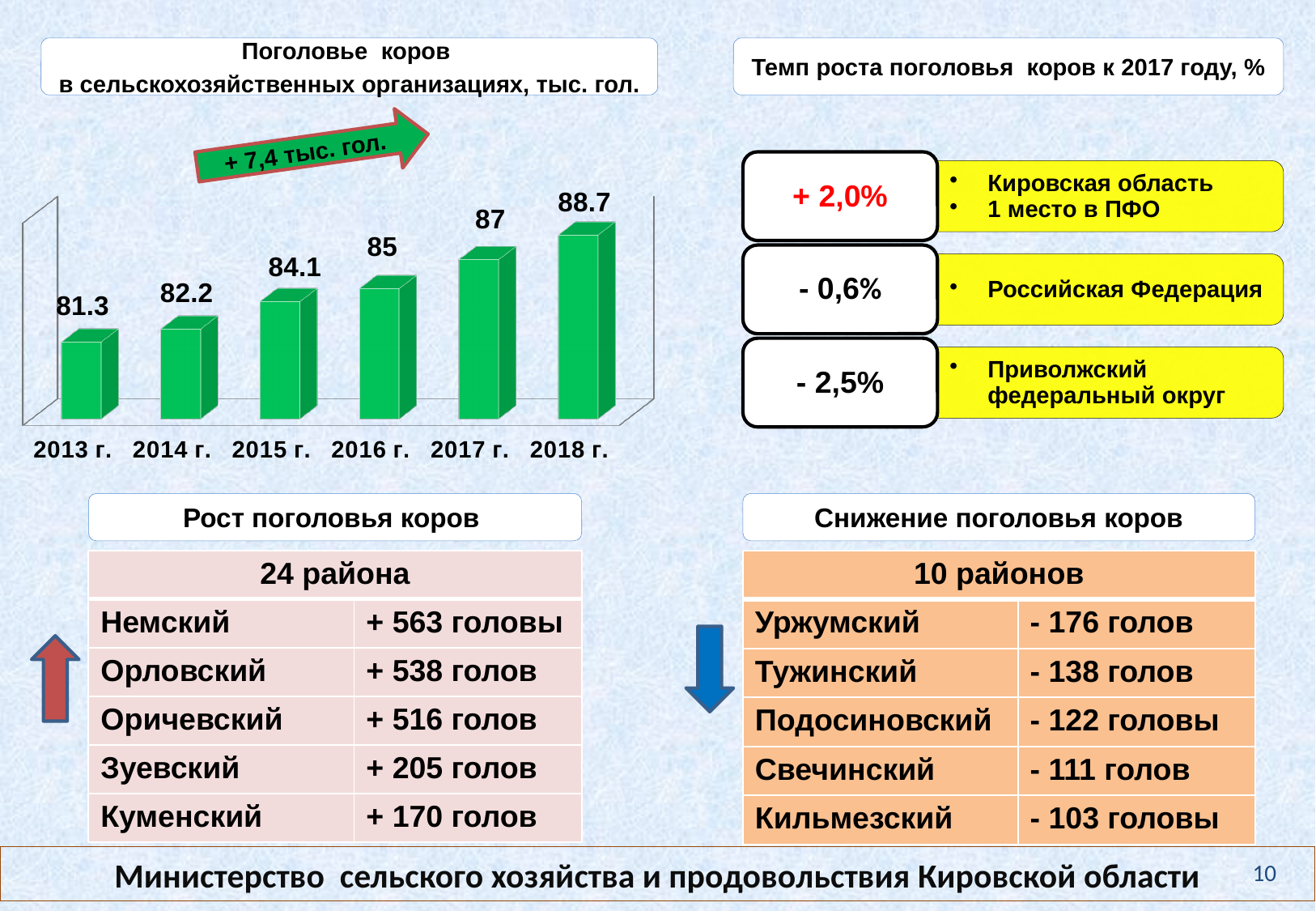
Do the values rise or fall from 2013 г. to 2018 г.? rise Which is larger, the value for 2015 г. or the value for 2014 г.? 2015 г. What is the value for 2016 г. in the chart? 85 What is the value for 2013 г. in the chart? 81.3 Which year has the lowest value in the chart? 2013 г. How many years are shown on the x axis of the chart? 6 What type of chart is shown on the slide? bar chart What is the difference between the values for 2017 г. and 2016 г.? 2 What is the title of the chart? Поголовье коров в сельскохозяйственных организациях, тыс. гол. Which year has the highest value in the chart? 2018 г. What is the value for 2018 г. in the chart? 88.7 What is the difference between the values for 2018 г. and 2013 г.? 7.4